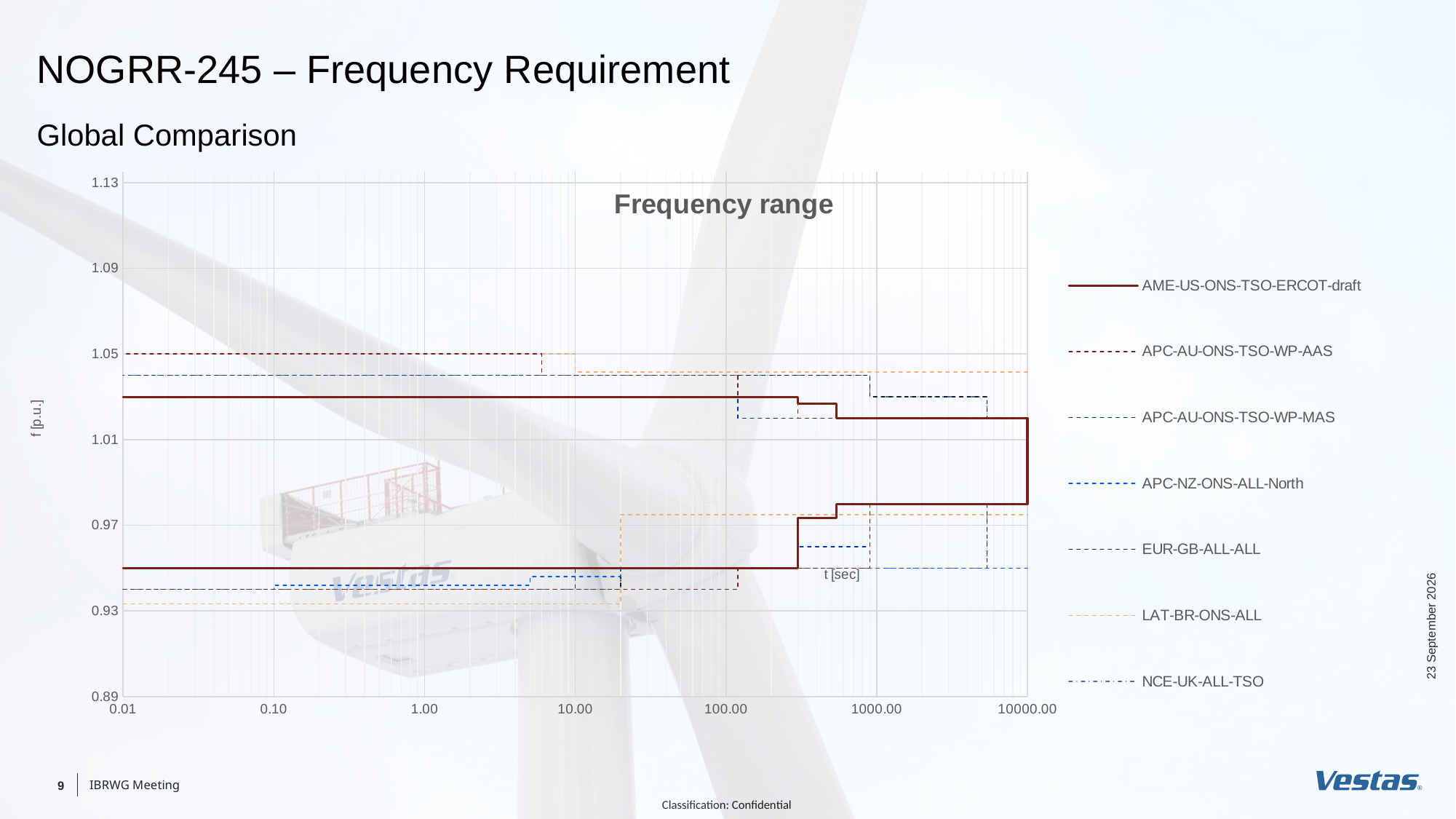
In the Frequency range chart, is the upper APC-AU-ONS-TSO-WP-AAS line at t = 1.00 sec greater or less than 1.01? greater Which series in the Frequency range chart is drawn with a solid line rather than a dashed one? AME-US-ONS-TSO-ERCOT-draft What is the title of the chart on the slide? Frequency range How many series does the legend of the Frequency range chart list? 7 In the Frequency range chart, is the lower AME-US-ONS-TSO-ERCOT-draft line at t = 1000.00 sec greater or less than 0.97? greater In the Frequency range chart, is the upper AME-US-ONS-TSO-ERCOT-draft line at t = 1.00 sec greater or less than 1.05? less In the Frequency range chart, does the upper AME-US-ONS-TSO-ERCOT-draft line rise or fall as t increases from 100 to 10000 sec? fall In the Frequency range chart, does the lower AME-US-ONS-TSO-ERCOT-draft line rise or fall as t increases from 100 to 10000 sec? rise What kind of chart is shown on the slide? Line chart